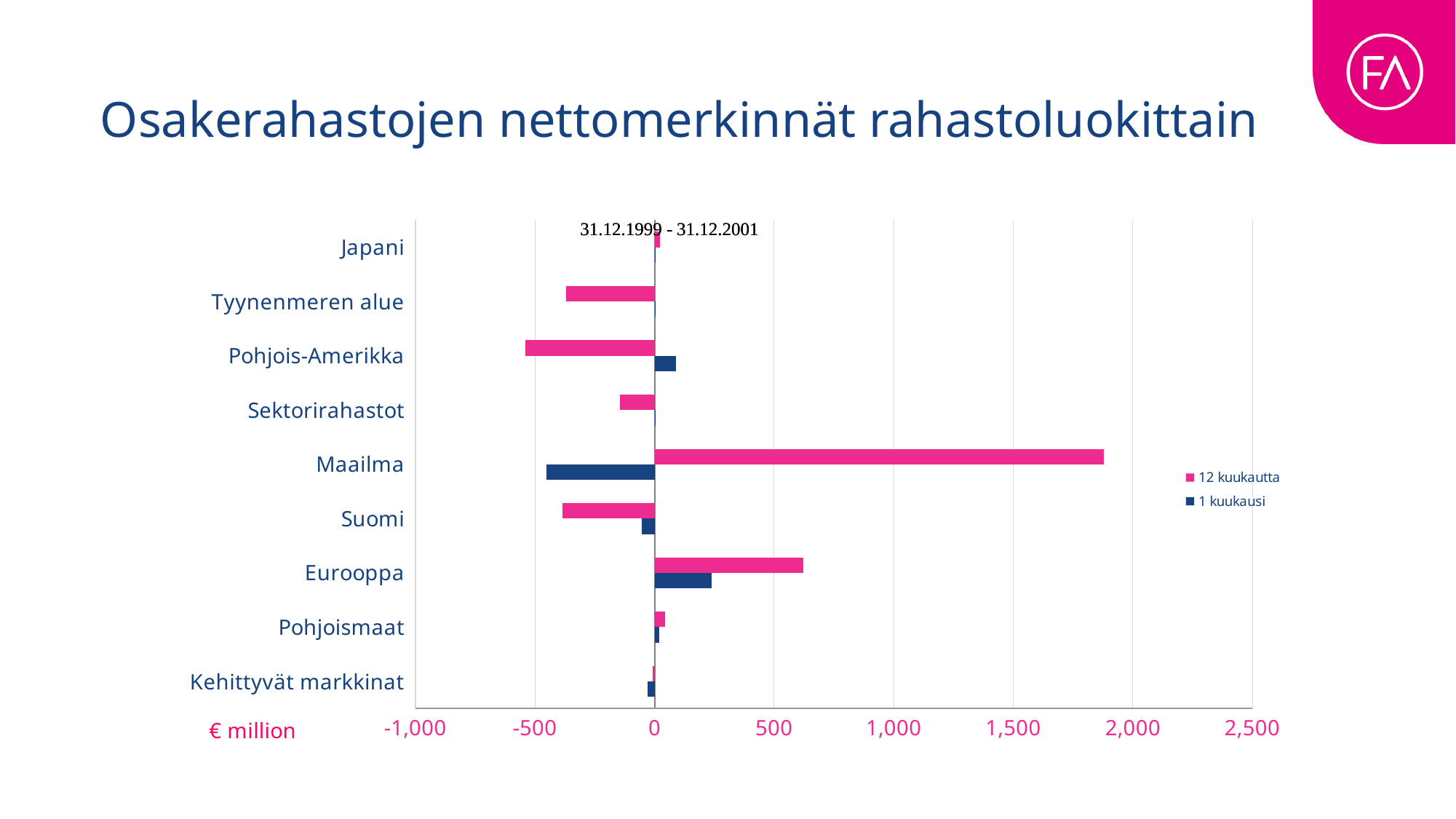
Which category has the lowest value for the 1 kuukausi series? Maailma Which category has the highest value for the 1 kuukausi series? Eurooppa For Eurooppa, which series has the larger value: 12 kuukautta or 1 kuukausi? 12 kuukautta How many series does the chart legend list? 2 Is the 12 kuukautta value for Maailma greater or less than 1,500? greater Which category has the lowest value for the 12 kuukautta series? Pohjois-Amerikka How many fund categories are listed on the vertical axis of the chart? 9 What kind of chart is shown on the slide? Bar chart Which category has the highest value for the 12 kuukautta series? Maailma What unit is shown for the horizontal axis of the chart? € million Is the 1 kuukausi value for Maailma greater or less than -500? greater Is the 12 kuukautta value for Eurooppa greater or less than 500? greater